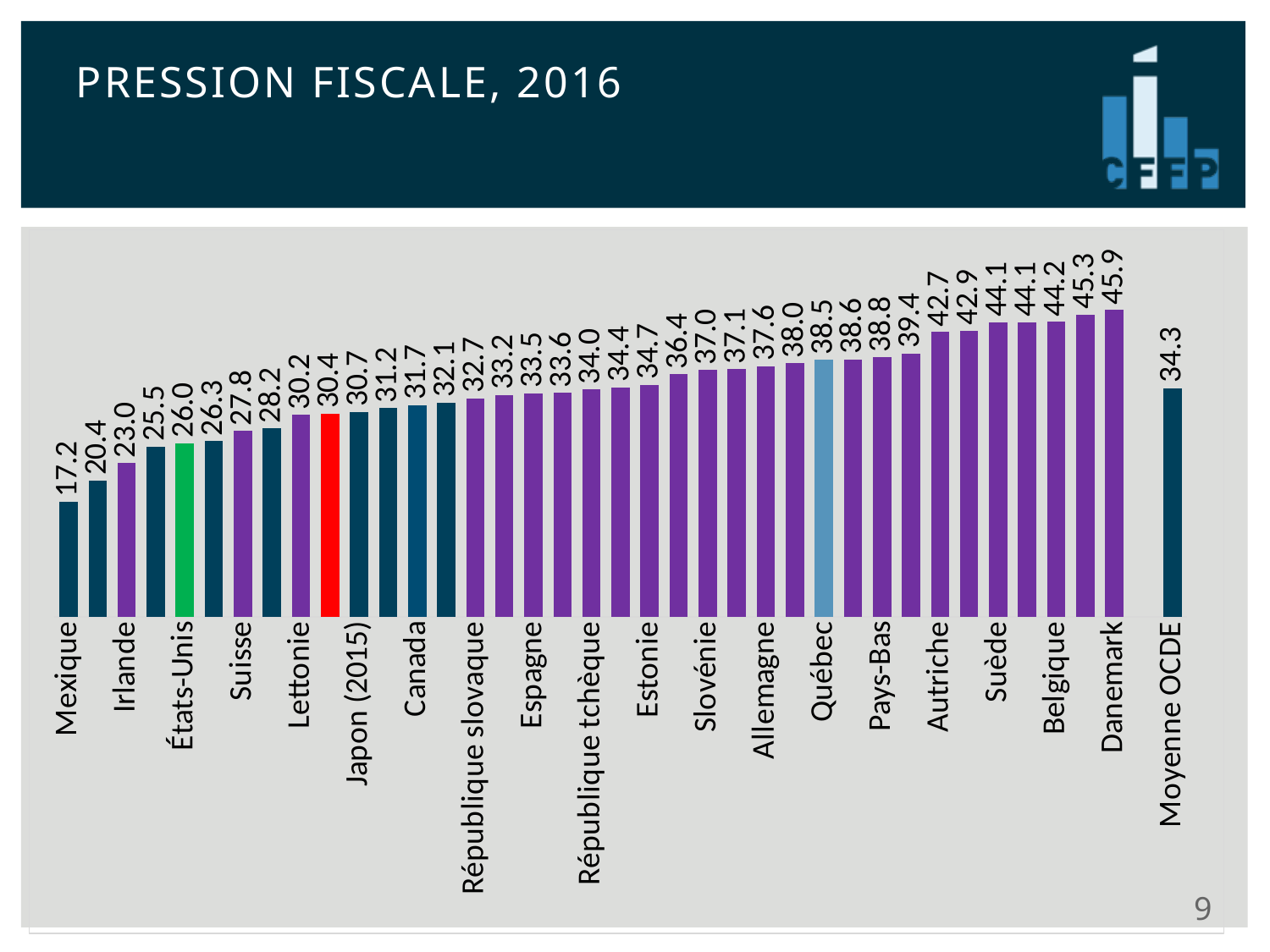
What is the value shown for Québec? 38.5 What kind of chart is shown on the slide? Bar chart What is the value shown for Moyenne OCDE? 34.3 What is the value shown for Mexique? 17.2 What is the title of the chart? PRESSION FISCALE, 2016 Which has the larger value, Allemagne or Québec? Québec What is the difference between the values for Québec and Canada? 6.8 Do the values generally rise or fall from left to right across the country bars? Rise Which labelled country has the highest value on the chart? Danemark Which labelled country has the lowest value on the chart? Mexique What is the difference between the values for Danemark and Mexique? 28.7 What is the value shown for Danemark? 45.9